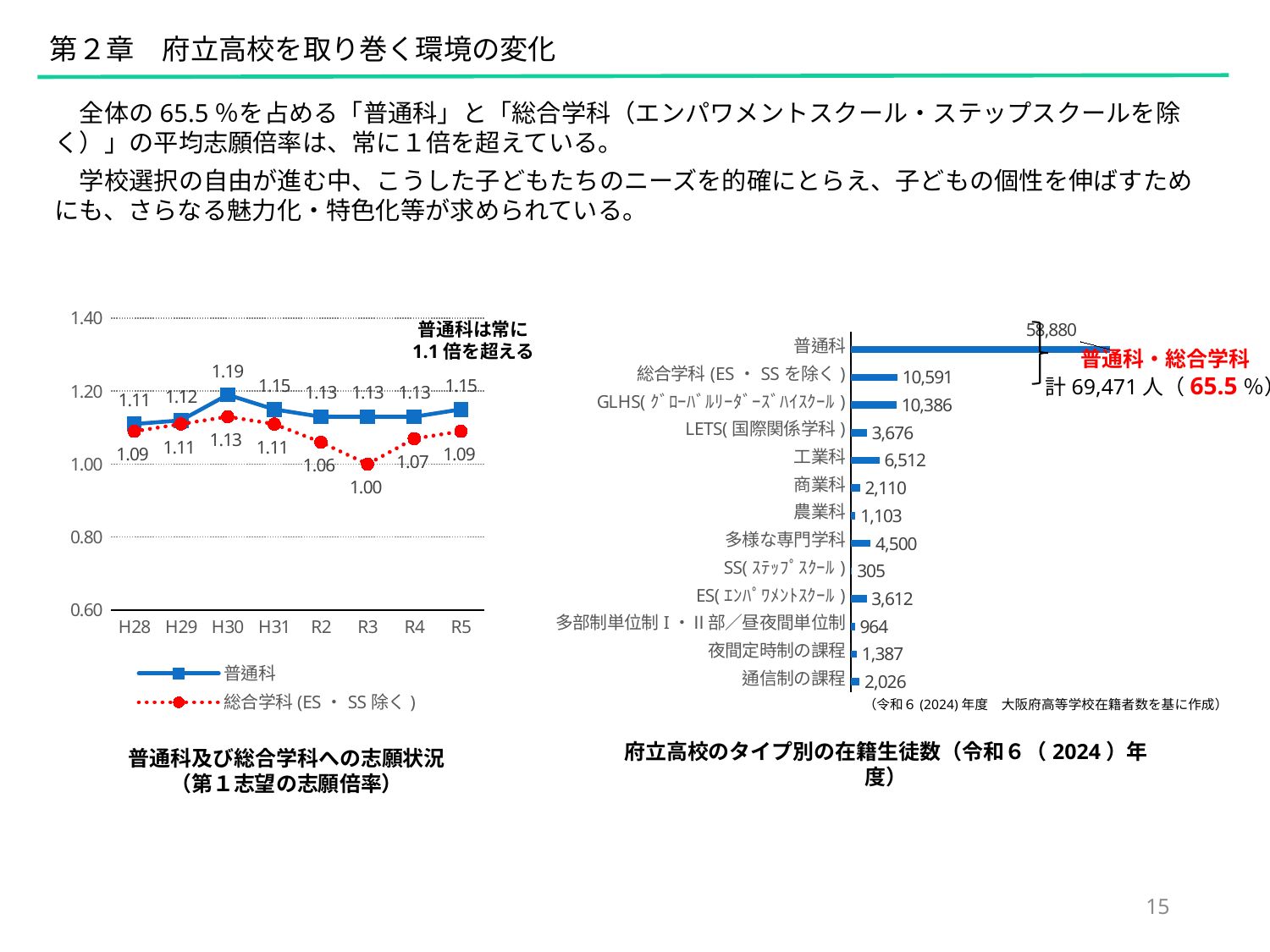
In the right chart (府立高校のタイプ別の在籍生徒数), what is the difference between 商業科 and 農業科? 1,007 In the right chart (府立高校のタイプ別の在籍生徒数), how many categories are shown? 13 In the right chart (府立高校のタイプ別の在籍生徒数), what is the value for 工業科? 6,512 In the right chart (府立高校のタイプ別の在籍生徒数), which category has the lowest value? SS(ステップスクール) In the left chart (普通科及び総合学科への志願状況), what kind of chart is it? Line chart In the left chart (普通科及び総合学科への志願状況), in which year is the 普通科 value highest? H30 In the left chart (普通科及び総合学科への志願状況), how many series does the legend list? 2 In the right chart (府立高校のタイプ別の在籍生徒数), which is larger, 総合学科 (ES・SSを除く) or GLHS? 総合学科 (ES・SSを除く) In the left chart (普通科及び総合学科への志願状況), in which year is the 総合学科 value lowest? R3 In the left chart (普通科及び総合学科への志願状況), what is the value for 普通科 in H30? 1.19 In the left chart (普通科及び総合学科への志願状況), what is the difference between the 普通科 and 総合学科 values in R3? 0.13 In the left chart (普通科及び総合学科への志願状況), what is the value for 総合学科 (ES・SS除く) in R3? 1.00